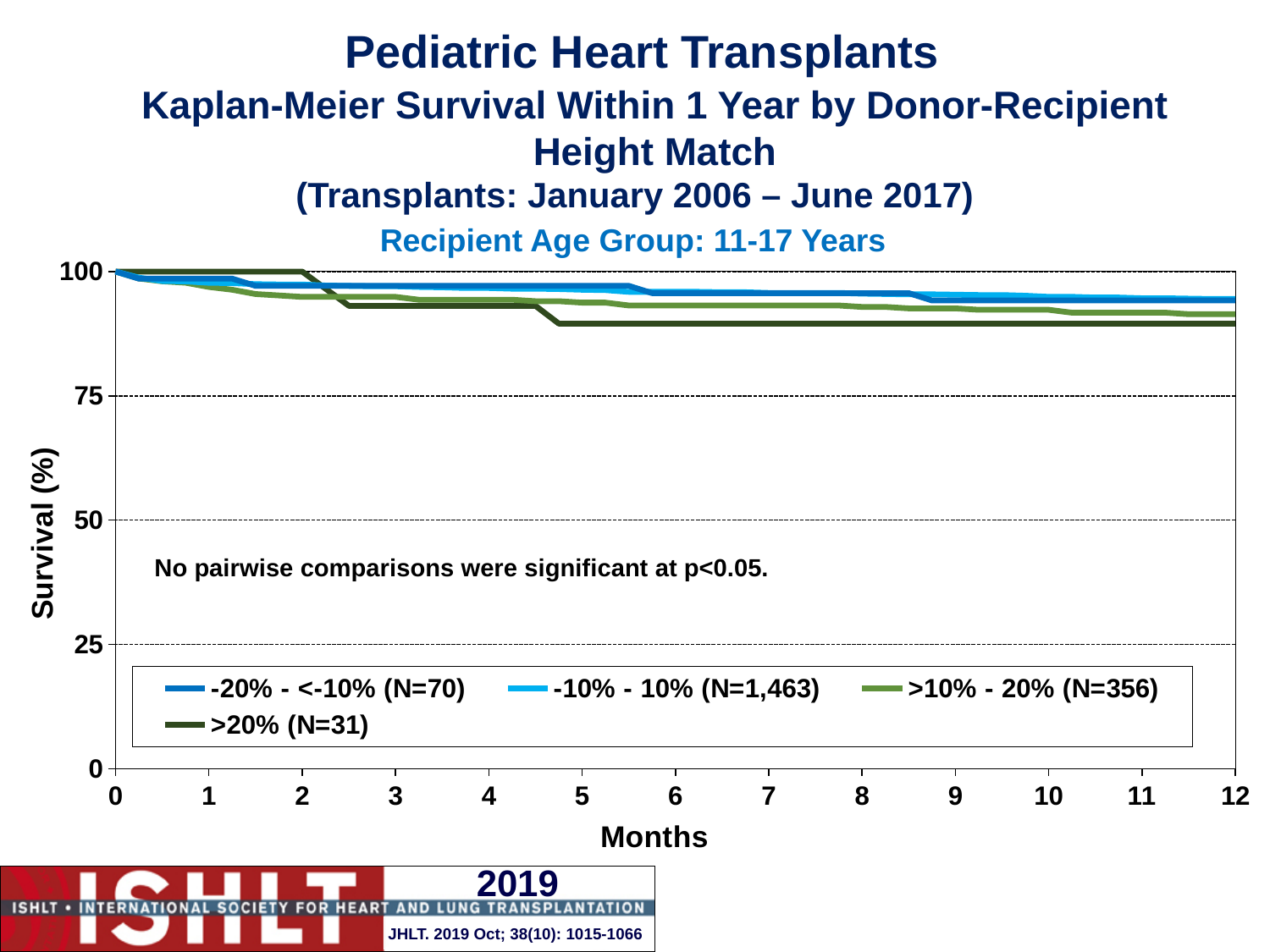
Which height match group has the largest N in the legend? -10% - 10% (N=1,463) Is the survival for the -10% - 10% group at 6 months greater or less than 75? greater Is the survival for the >20% group at 12 months greater or less than 75? greater How many series does the legend list? 4 What kind of chart is shown on the slide? Line chart What is the N for the -20% - <-10% height match group shown in the legend? N=70 What is the N for the -10% - 10% height match group shown in the legend? N=1,463 What is the label of the y axis? Survival (%) Which height match group has the lowest survival curve at 12 months? >20% (N=31) Do the survival curves rise or fall as months increase? Fall What is the N for the >20% height match group shown in the legend? N=31 Which height match group has the smallest N in the legend? >20% (N=31)